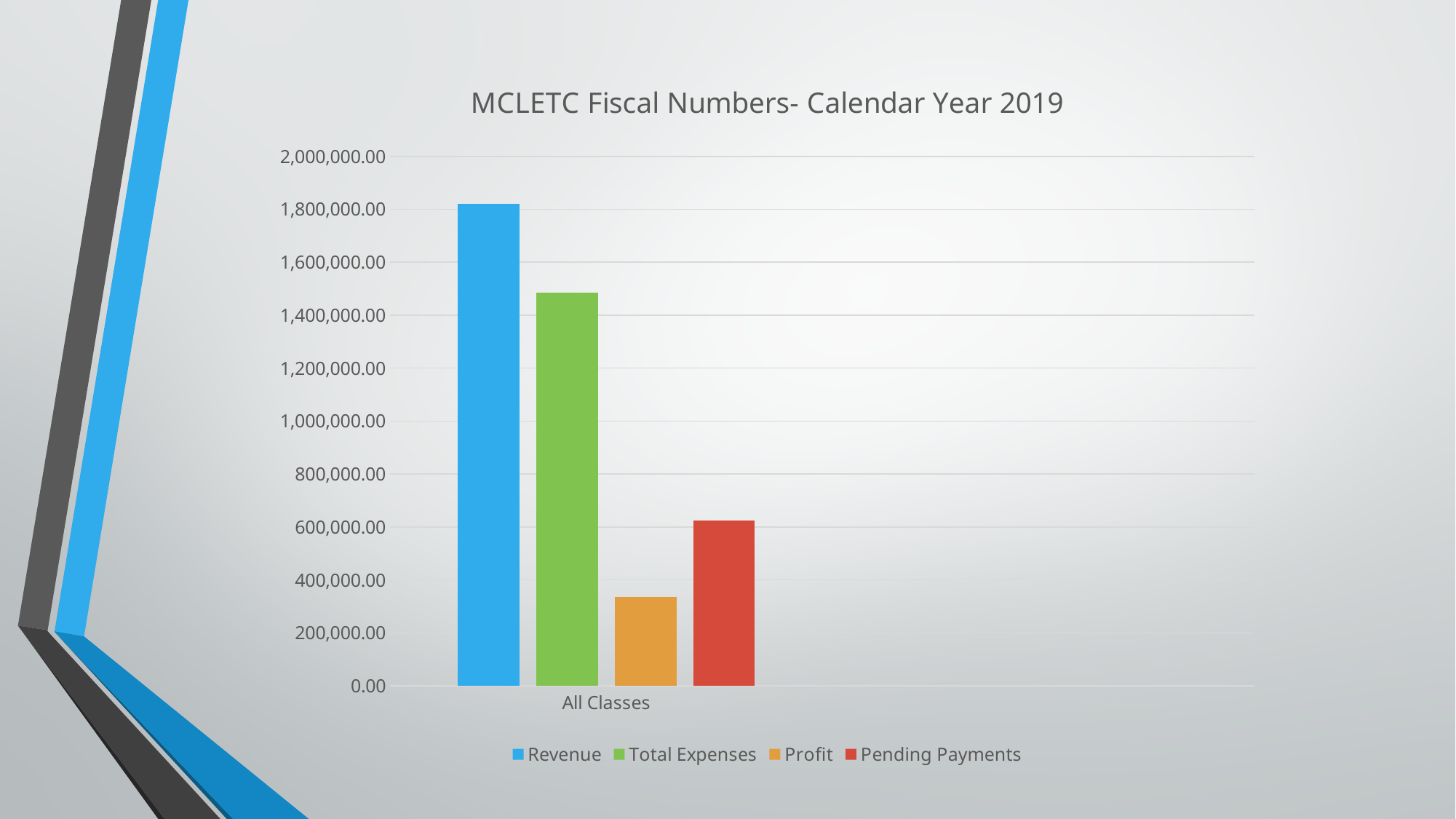
Which series has the highest value for All Classes? Revenue Which is larger, Pending Payments or Profit? Pending Payments Is the value for Total Expenses greater or less than 1,600,000.00? less Is the value for Profit greater or less than 400,000.00? less What colour is the bar for Total Expenses? green Which series has the lowest value for All Classes? Profit What kind of chart is shown on the slide? bar chart Is the value for Pending Payments greater or less than 600,000.00? greater How many series does the legend list? 4 What is the title of the chart? MCLETC Fiscal Numbers- Calendar Year 2019 How many categories are shown on the x axis? 1